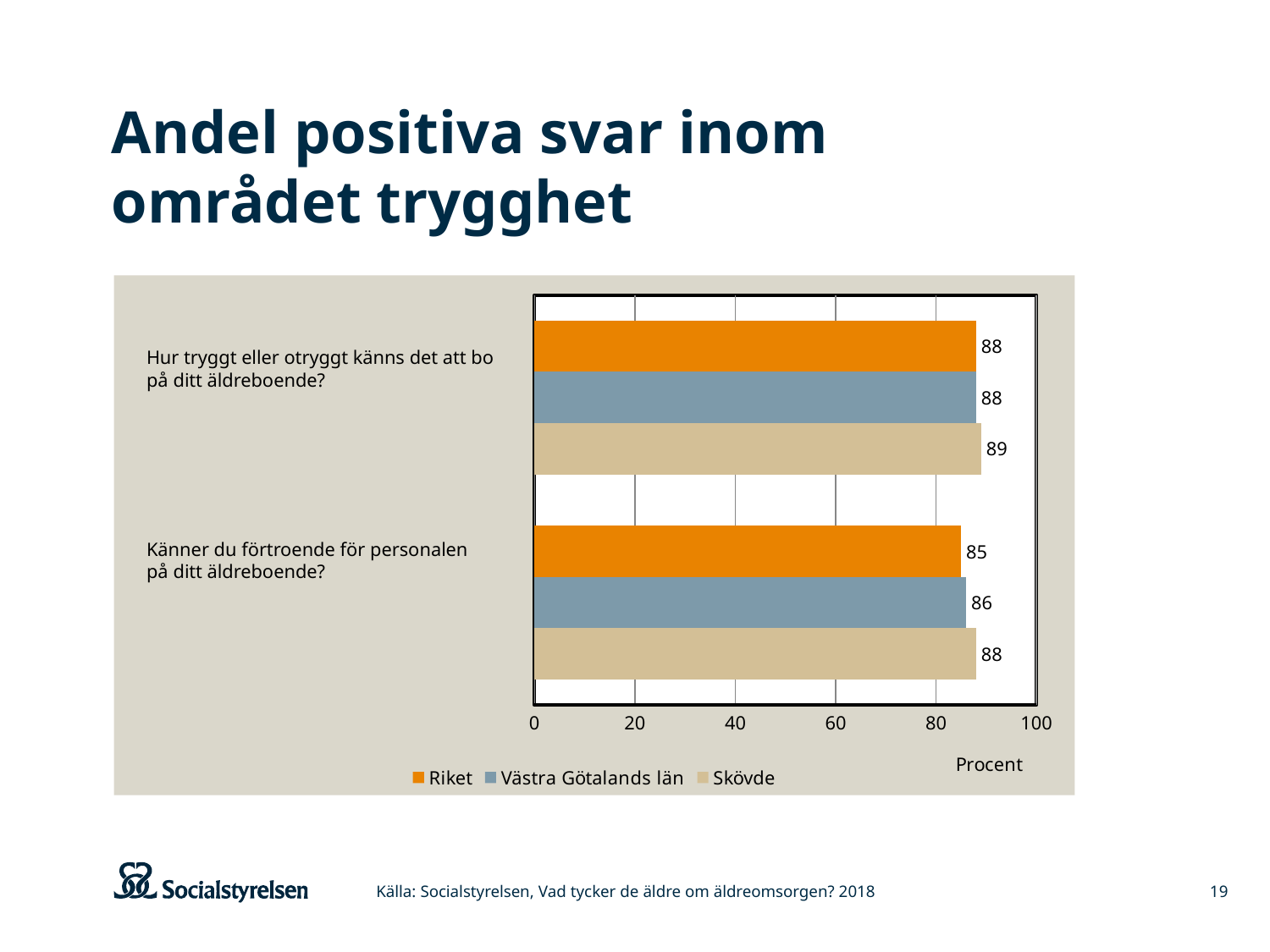
Which is larger: the Skövde value for "Hur tryggt eller otryggt känns det att bo på ditt äldreboende?" or the Skövde value for "Känner du förtroende för personalen på ditt äldreboende?"? Hur tryggt eller otryggt känns det att bo på ditt äldreboende? What is the difference between the Skövde value and the Riket value on the question "Känner du förtroende för personalen på ditt äldreboende?"? 3 How many series does the legend list? 3 What is the value for Riket on the question "Känner du förtroende för personalen på ditt äldreboende?"? 85 What is the value for Skövde on the question "Hur tryggt eller otryggt känns det att bo på ditt äldreboende?"? 89 Is the value for Riket on "Känner du förtroende för personalen på ditt äldreboende?" greater or less than 80? greater What is the value for Riket on the question "Hur tryggt eller otryggt känns det att bo på ditt äldreboende?"? 88 Which series has the lowest value on the question "Känner du förtroende för personalen på ditt äldreboende?"? Riket How many questions (categories) are shown on the chart? 2 What is the value for Västra Götalands län on the question "Känner du förtroende för personalen på ditt äldreboende?"? 86 What kind of chart is shown on the slide? Bar chart Which series has the highest value on the question "Hur tryggt eller otryggt känns det att bo på ditt äldreboende?"? Skövde